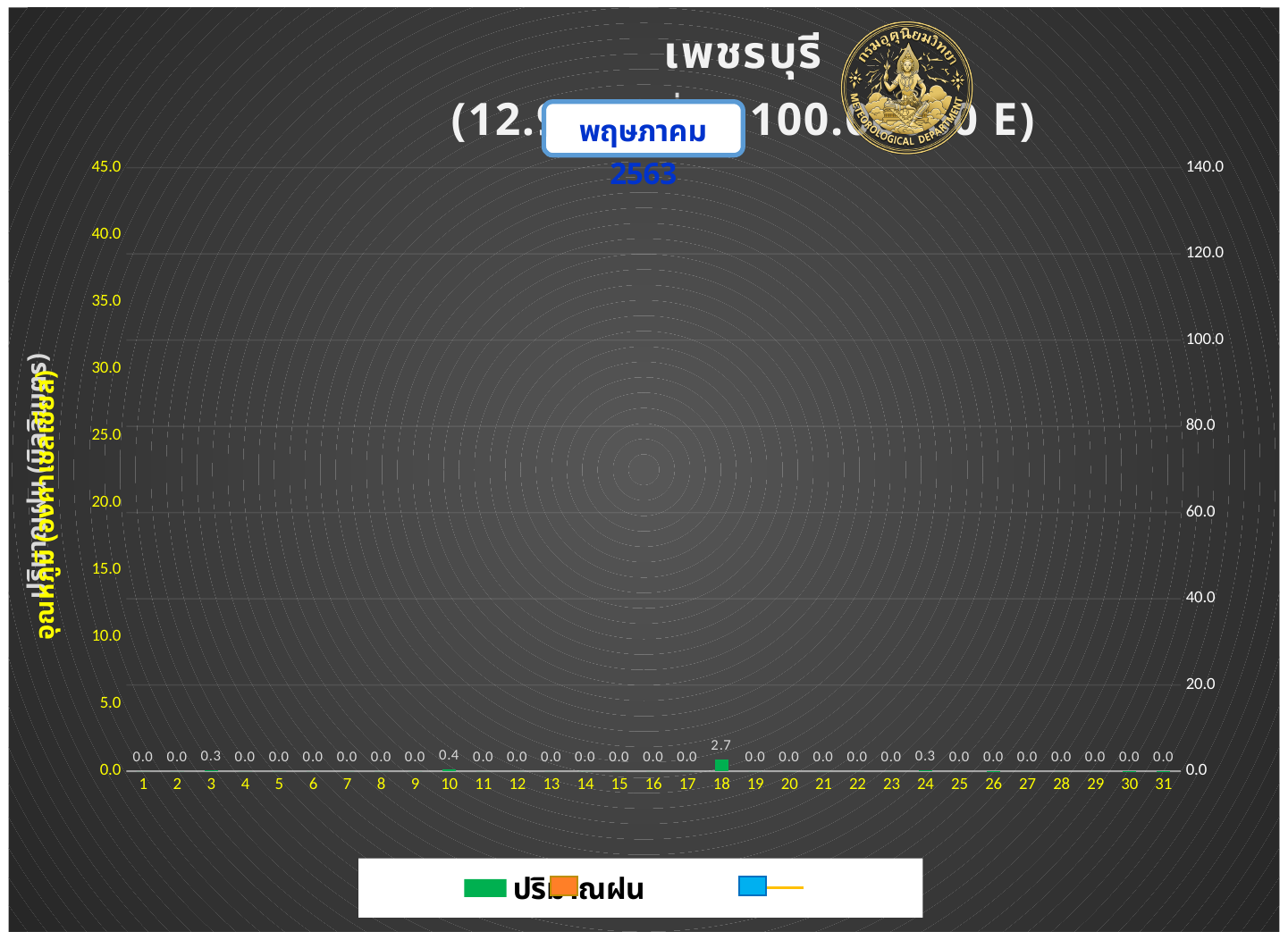
Which has a larger rainfall value, day 18 or day 10? day 18 What is the rainfall value shown for day 1? 0.0 What is the rainfall value shown for day 24? 0.3 What is the rainfall value shown for day 3? 0.3 What is the highest tick value on the right-hand axis? 140.0 What kind of chart is used to show the rainfall values? bar chart What is the rainfall value shown for day 10? 0.4 Which day has the highest rainfall value? 18 Is the rainfall value for day 18 greater or less than 5.0 on the left axis? less What is the difference between the rainfall values for day 18 and day 10? 2.3 How many days are shown along the x axis? 31 What is the rainfall value shown for day 18? 2.7